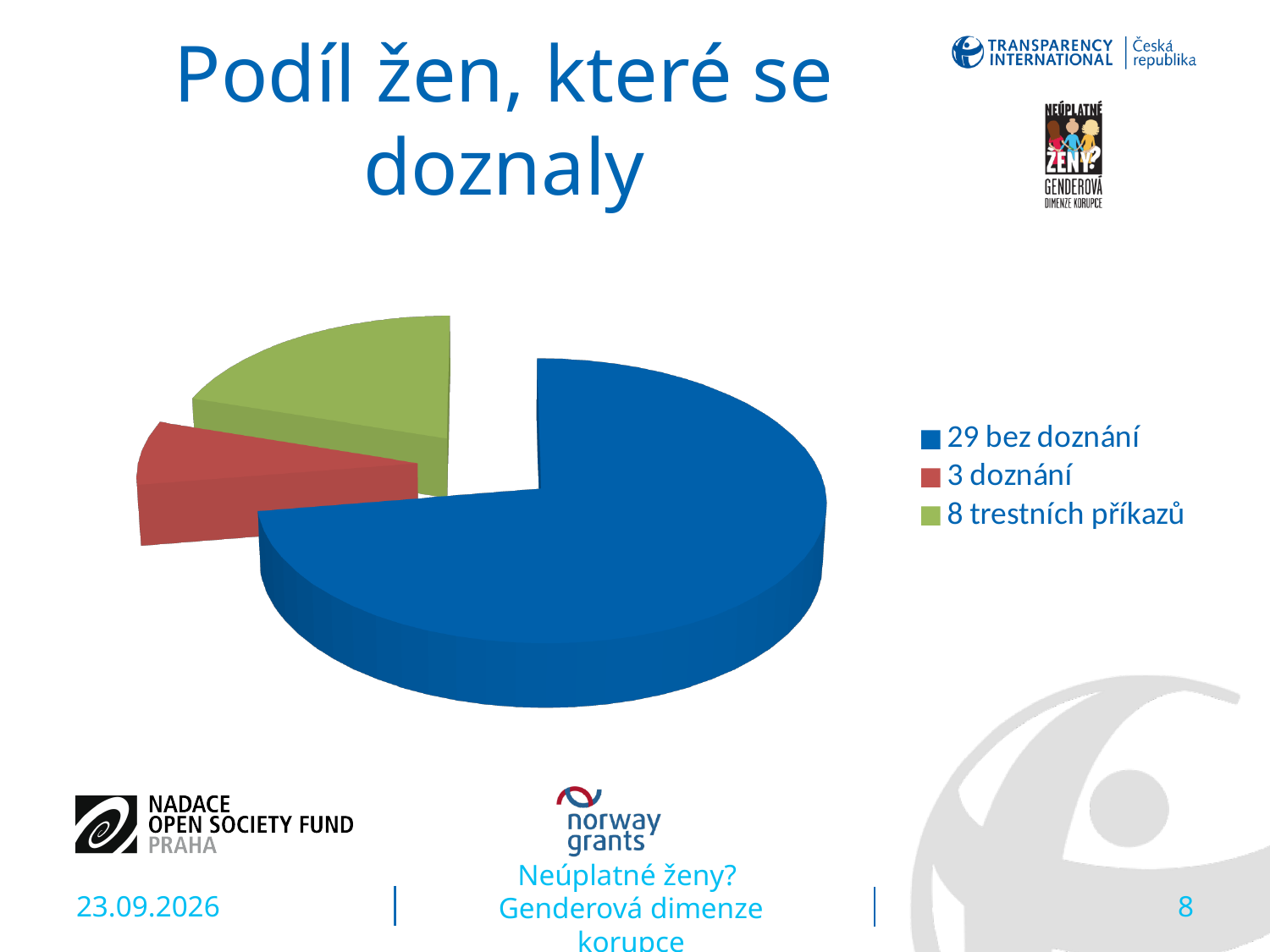
What kind of chart is shown on the slide? pie chart What is the number of women given in the legend for the 'bez doznání' category? 29 Which is larger, the 'bez doznání' slice or the 'trestních příkazů' slice? bez doznání What colour is the largest slice of the pie chart? blue How many slices does the pie chart have? 3 Which category has the largest slice in the pie chart? 29 bez doznání What is the total of all three values shown in the legend? 40 What is the number given in the legend for the 'trestních příkazů' category? 8 How many entries does the legend of the pie chart list? 3 Which category has the smallest slice in the pie chart? 3 doznání What is the difference between the 'trestních příkazů' value and the 'doznání' value? 5 What is the difference between the 'bez doznání' value and the 'doznání' value? 26